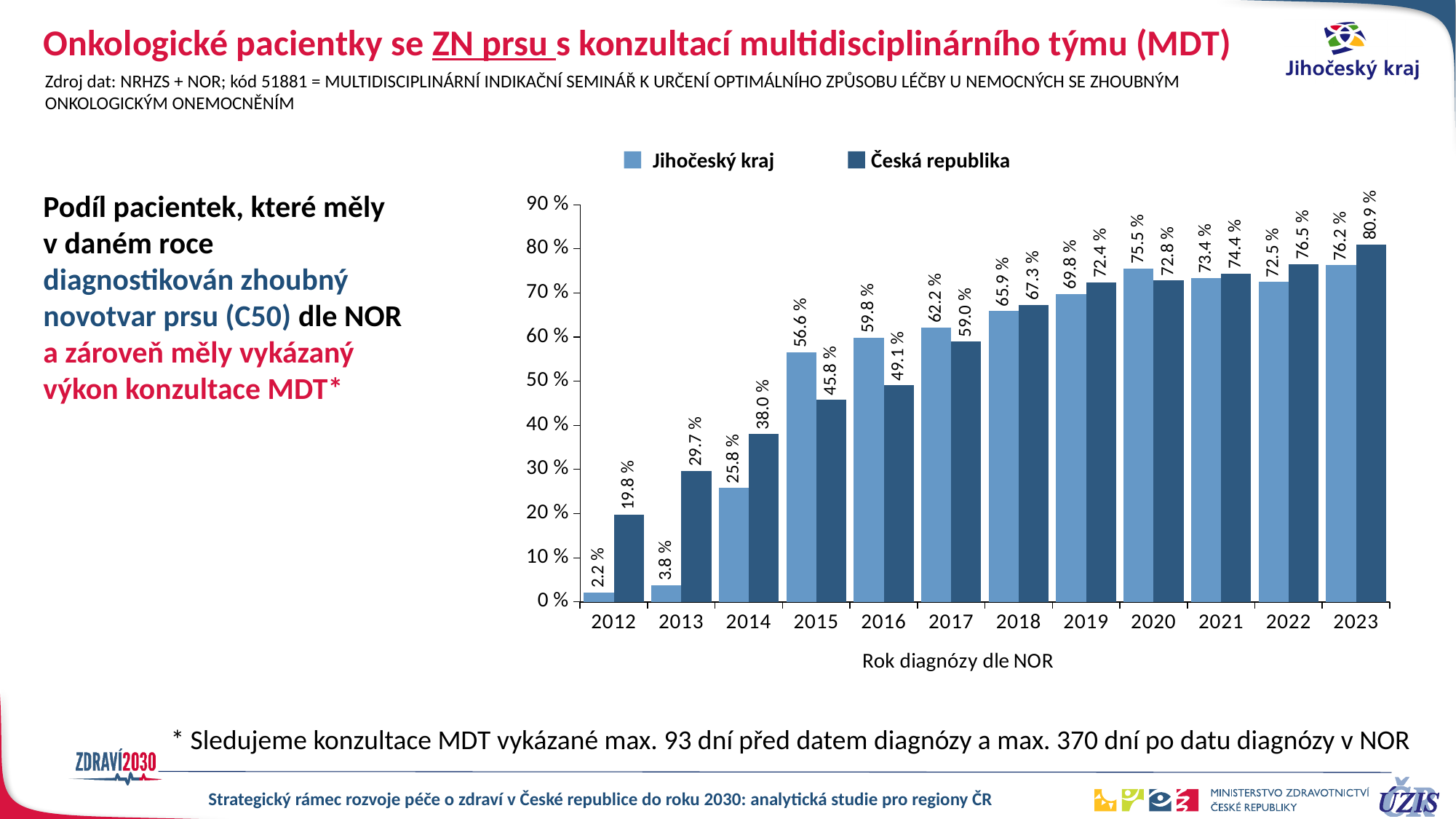
How many years are shown on the x axis? 12 What kind of chart is shown on the slide? bar chart What is the difference between the Česká republika and Jihočeský kraj values in 2023? 4.7 % What is the value for Jihočeský kraj in 2015? 56.6 % How many series does the legend list? 2 Is the value for Jihočeský kraj in 2014 greater or less than 30 %? less What is the difference between the Česká republika and Jihočeský kraj values in 2012? 17.6 % In 2020, which series has the larger value, Jihočeský kraj or Česká republika? Jihočeský kraj What is the value for Česká republika in 2023? 80.9 % In which year is the value for Česká republika the highest? 2023 In which year is the value for Jihočeský kraj the lowest? 2012 Do the values for Česká republika generally rise or fall from 2012 to 2023? rise